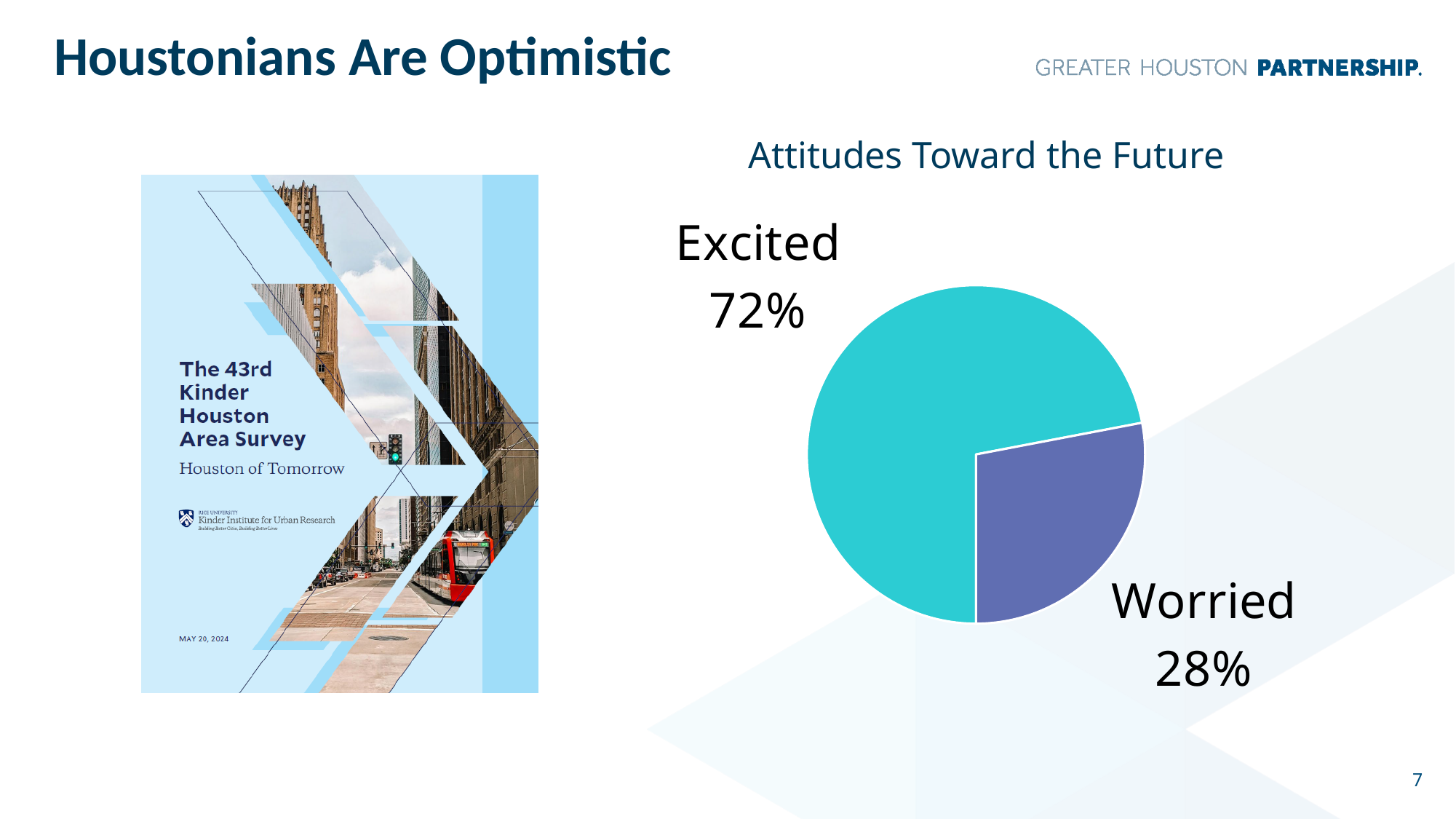
Which category has the smallest share of the pie? Worried What kind of chart is shown on the slide? Pie chart What is the difference in percentage points between Excited and Worried? 44 What share of the pie does the Worried slice represent? 28% Which is larger, the share for Excited or the share for Worried? Excited Which category has the largest share of the pie? Excited What is the title of the chart? Attitudes Toward the Future How many categories does the pie chart show? 2 What percentage of respondents are Worried about the future? 28% What percentage of respondents are Excited about the future? 72% What colour is the Excited slice of the pie? Teal